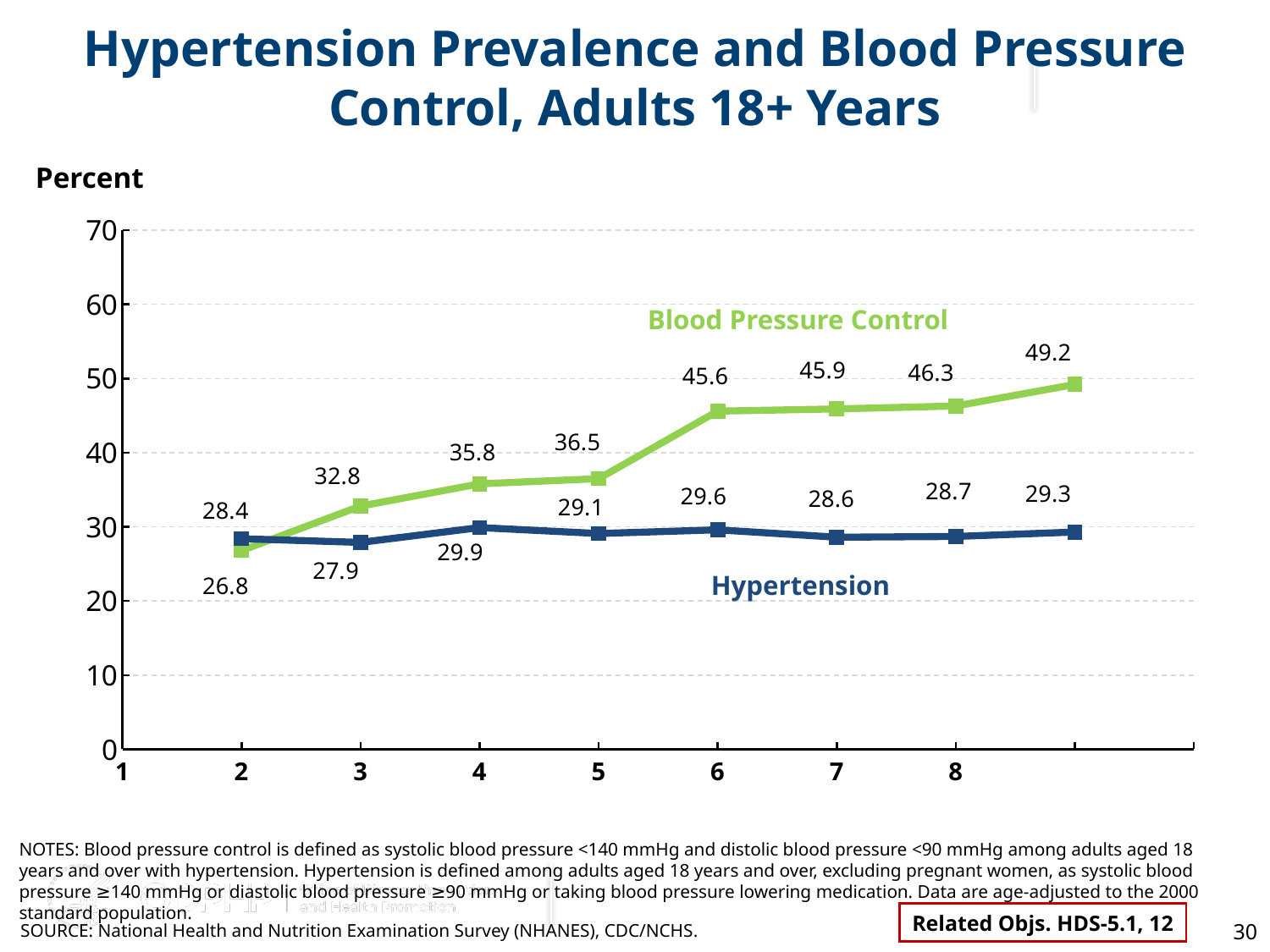
At x-axis position 2, which is larger: Blood Pressure Control or Hypertension? Hypertension What is the label of the y axis? Percent What kind of chart is shown on the slide? Line chart Does the Blood Pressure Control line generally rise or fall along the x axis? Rise What is the Hypertension value at x-axis position 4? 29.9 What is the highest value shown for the Blood Pressure Control line? 49.2 What is the lowest value shown for the Hypertension line? 27.9 What is the difference between the Blood Pressure Control and Hypertension values at x-axis position 6? 16.0 How many data points are plotted on the Hypertension line? 8 How many data series are plotted on the chart? 2 What is the Blood Pressure Control value at x-axis position 6? 45.6 What is the Blood Pressure Control value at x-axis position 3? 32.8